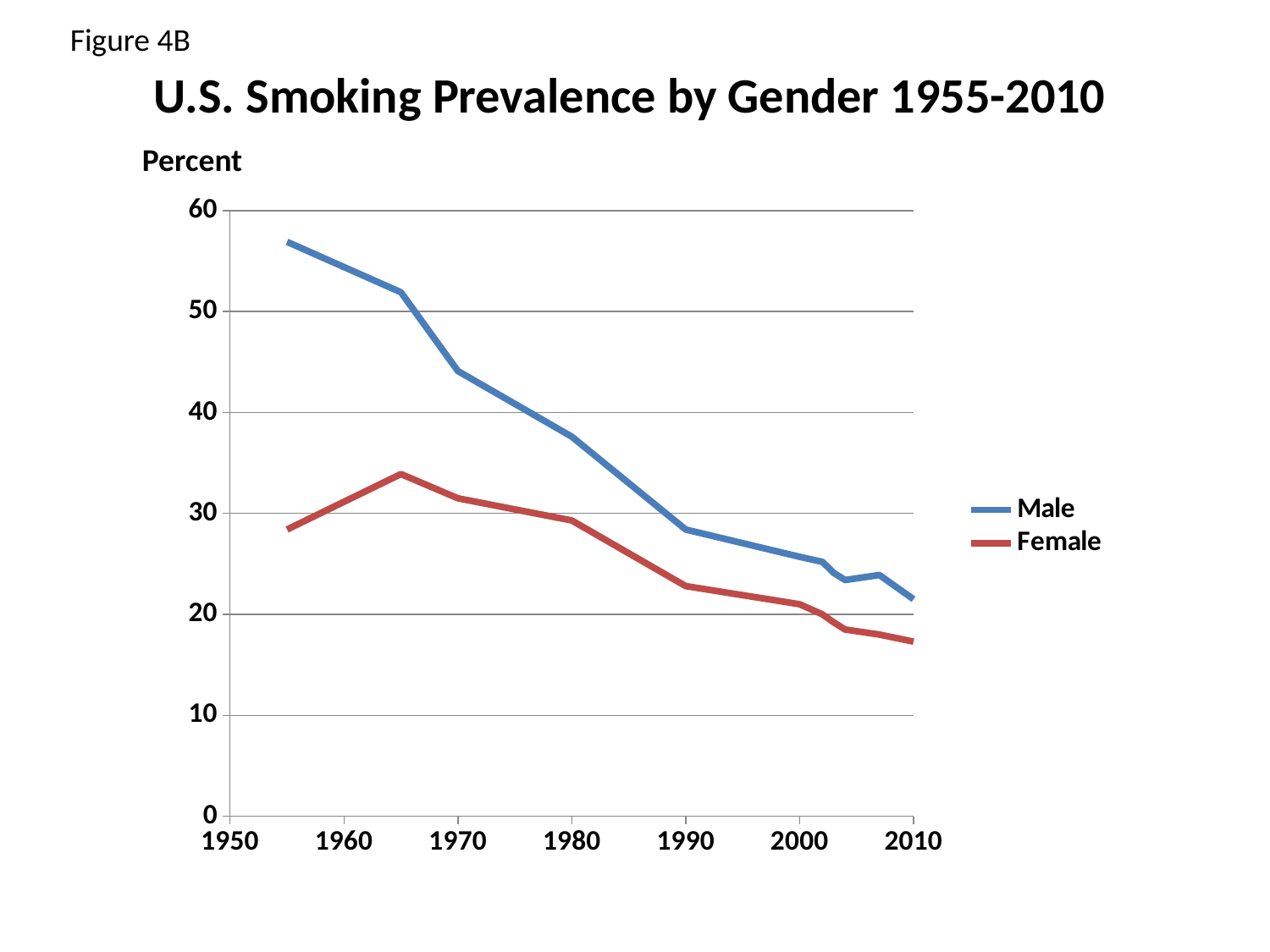
What kind of chart is shown on the slide? line chart Does the Male series rise or fall from 1955 to 2010? fall In which year does the Female series reach its highest value? 1965 How many series does the legend list? 2 In 1980, which series has the higher value, Male or Female? Male Is the Female value in 2010 greater or less than 20? less Is the Male value in 1990 greater or less than 30? less What are the two series named in the legend? Male and Female Is the Male value in 1970 greater or less than 40? greater What is the label on the vertical axis? Percent